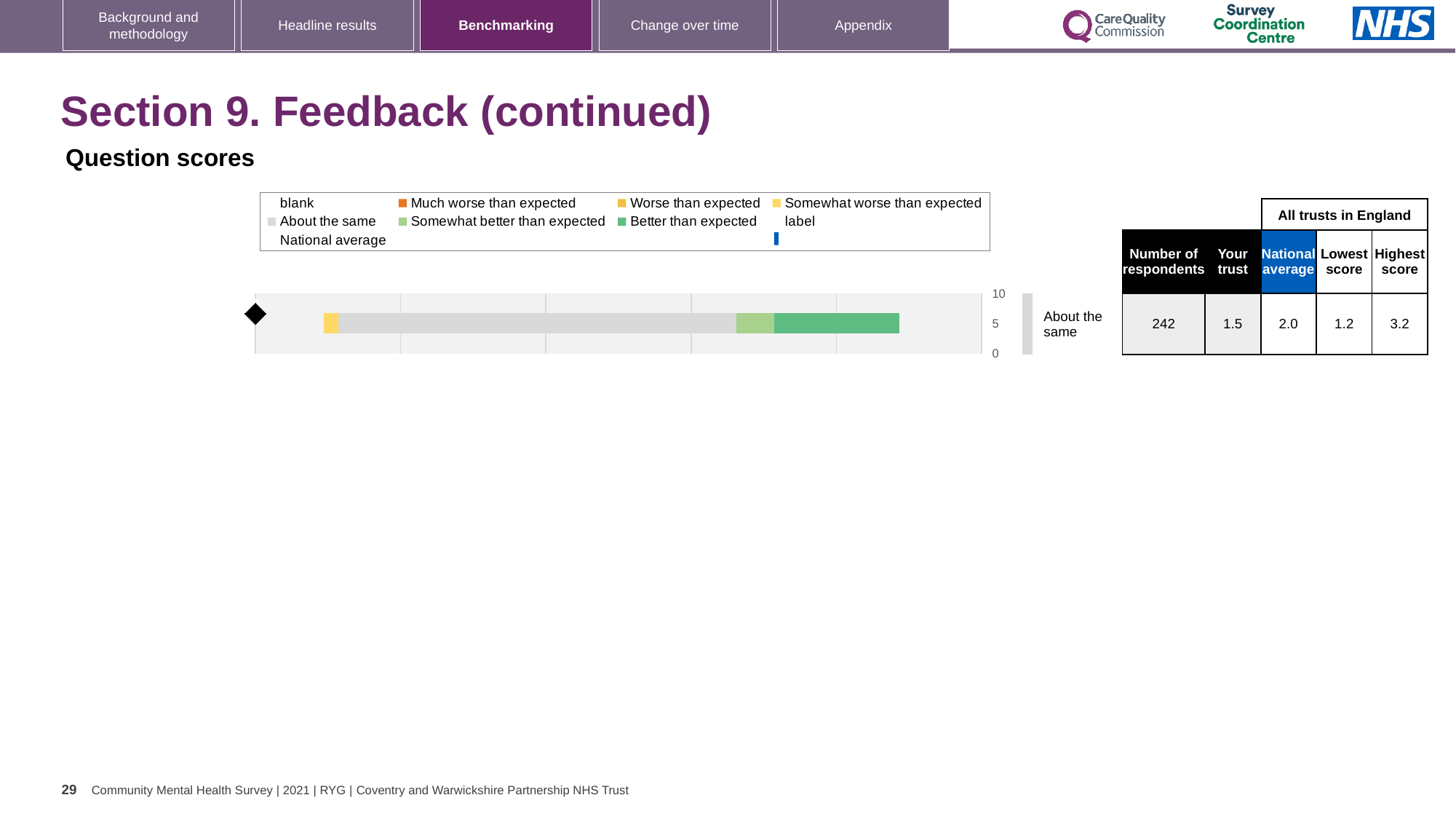
What is the National average score shown in the table? 2.0 Which is larger, the 'Your trust' score or the National average? National average How many question rows (categories) are plotted in the chart? 1 What is the 'Your trust' score shown in the table for this question? 1.5 How many respondents are shown in the table for this question? 242 What is the benchmark category shown next to the bar? About the same What kind of chart is shown on the slide? bar chart What is the Lowest score among all trusts in England shown in the table? 1.2 What is the Highest score among all trusts in England shown in the table? 3.2 What is the difference between the Highest score and the Lowest score in the table? 2.0 What is the highest tick value shown on the chart's axis? 10 What is the difference between the National average and the 'Your trust' score? 0.5